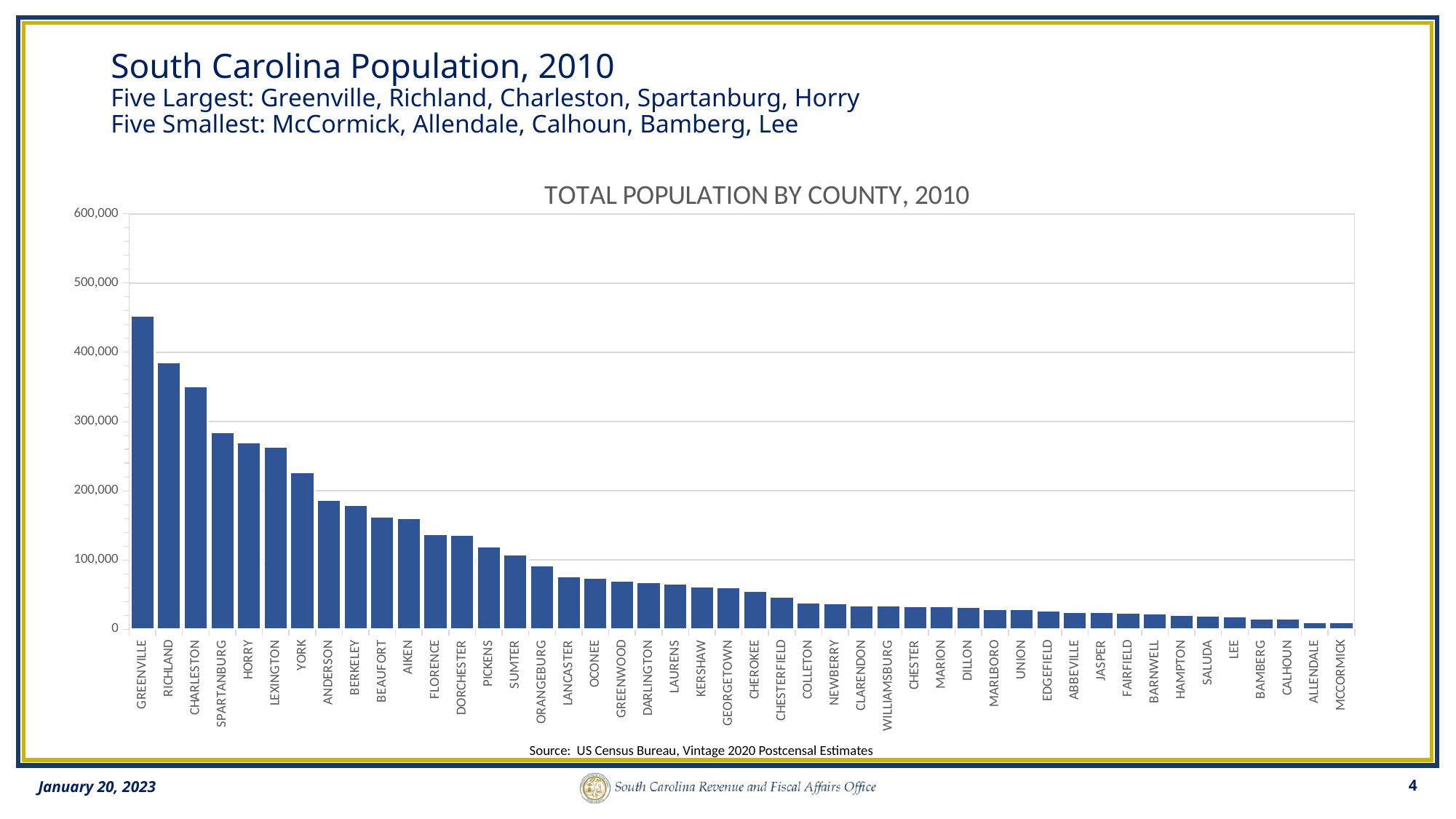
Which county has the lowest population in the chart? McCormick What type of chart is shown on the slide? Bar chart Which county has the highest population in the chart? Greenville Is the population of Richland greater or less than 400,000? less Is the population of Orangeburg greater or less than 100,000? less How many counties are plotted in the chart? 46 Do the bar values rise or fall moving from left to right along the x axis? Fall What is the title of the chart? TOTAL POPULATION BY COUNTY, 2010 Is the population of Charleston greater or less than 300,000? greater Which county has a larger population, York or Anderson? York